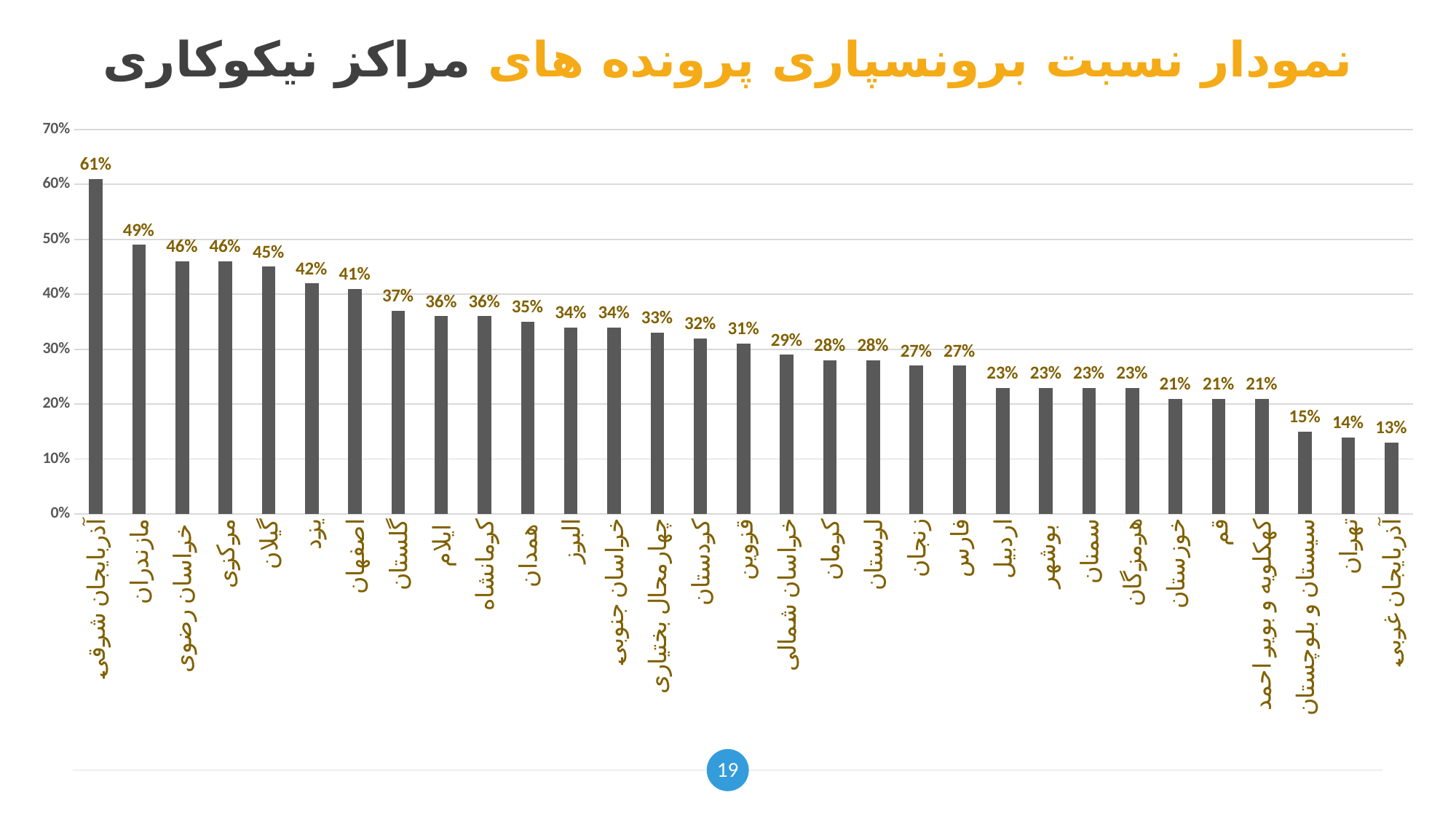
Which category has the highest value? آذربایجان شرقی What is the difference between the values for گیلان and سیستان و بلوچستان? 30% Which category has the lowest value? آذربایجان غربی What is the value for کردستان? 32% How many categories are shown on the x axis? 31 Is the value for قزوین greater or less than 40%? less Which is larger, the value for یزد or the value for همدان? یزد What is the difference between the values for آذربایجان شرقی and مازندران? 12% What is the value for اصفهان? 41% Do the values rise or fall from left to right along the x axis? fall What kind of chart is shown on the slide? bar chart What is the value for تهران? 14%